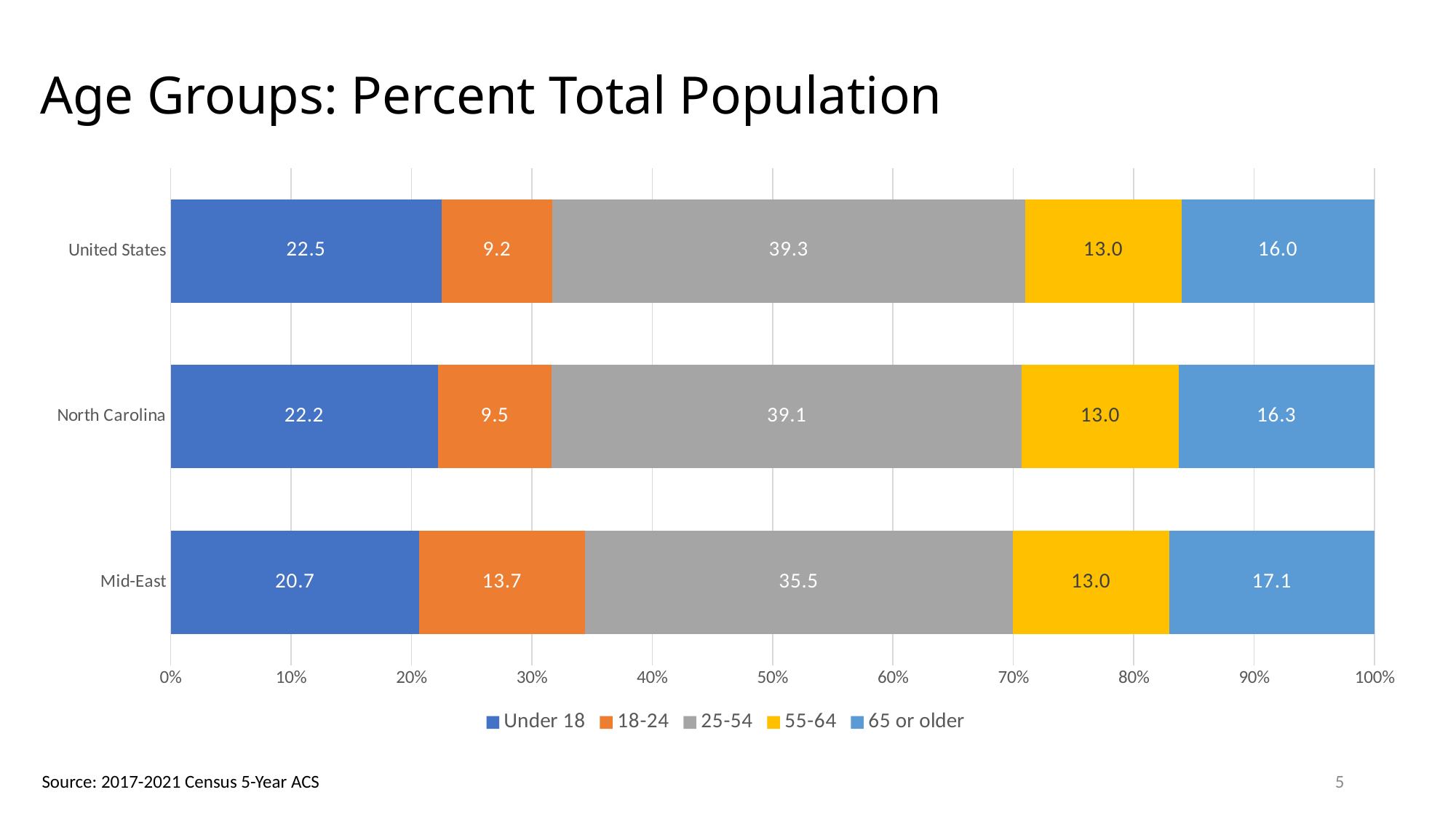
Which is larger, the 65 or older value for Mid-East or for the United States? Mid-East How many age groups does the legend list? 5 How many regions are shown on the chart? 3 What kind of chart is shown on the slide? Stacked bar chart Which region has the highest value for the 18-24 age group? Mid-East What is the value for the 25-54 age group in the United States? 39.3 What is the total of the stacked bar for North Carolina? 100.1 Which region has the lowest value for the Under 18 age group? Mid-East What is the difference between the 25-54 values for the United States and Mid-East? 3.8 What is the value for the 65 or older age group in North Carolina? 16.3 What is the title of the chart? Age Groups: Percent Total Population What is the value for the 18-24 age group in Mid-East? 13.7